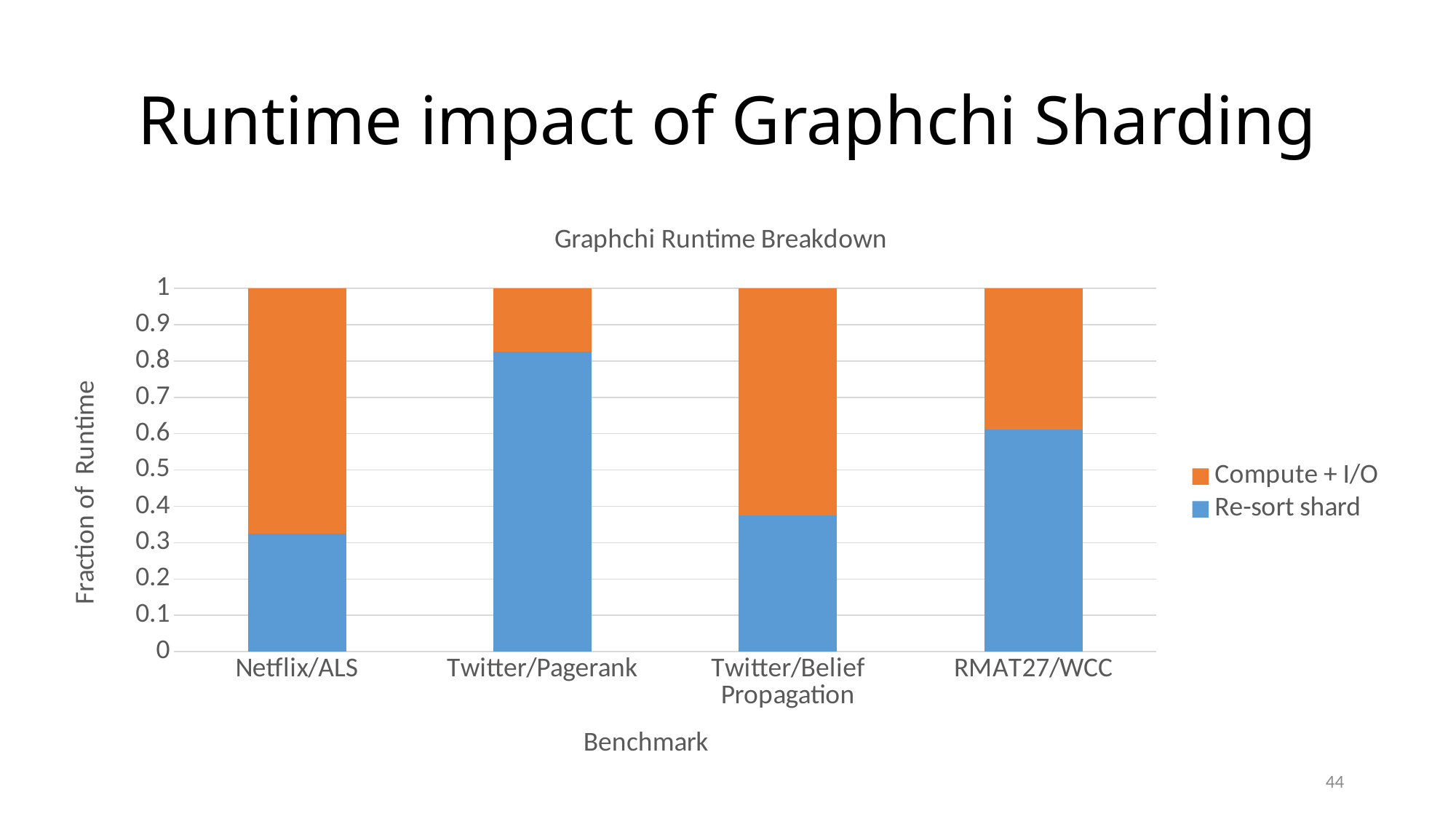
How many benchmarks are shown on the x axis of the chart? 4 Which has a larger Re-sort shard fraction, Twitter/Pagerank or Netflix/ALS? Twitter/Pagerank Which benchmark has the largest Compute + I/O fraction of runtime? Netflix/ALS How many series does the chart's legend list? 2 Is the Re-sort shard fraction for Netflix/ALS greater or less than 0.4? less Is the Re-sort shard fraction for Twitter/Pagerank greater or less than 0.8? greater Is the Re-sort shard fraction for RMAT27/WCC greater or less than 0.5? greater What is the total height of the stacked bar for RMAT27/WCC? 1 What kind of chart is shown on the slide? Stacked bar chart What is the title of the chart? Graphchi Runtime Breakdown Which benchmark has the largest Re-sort shard fraction of runtime? Twitter/Pagerank